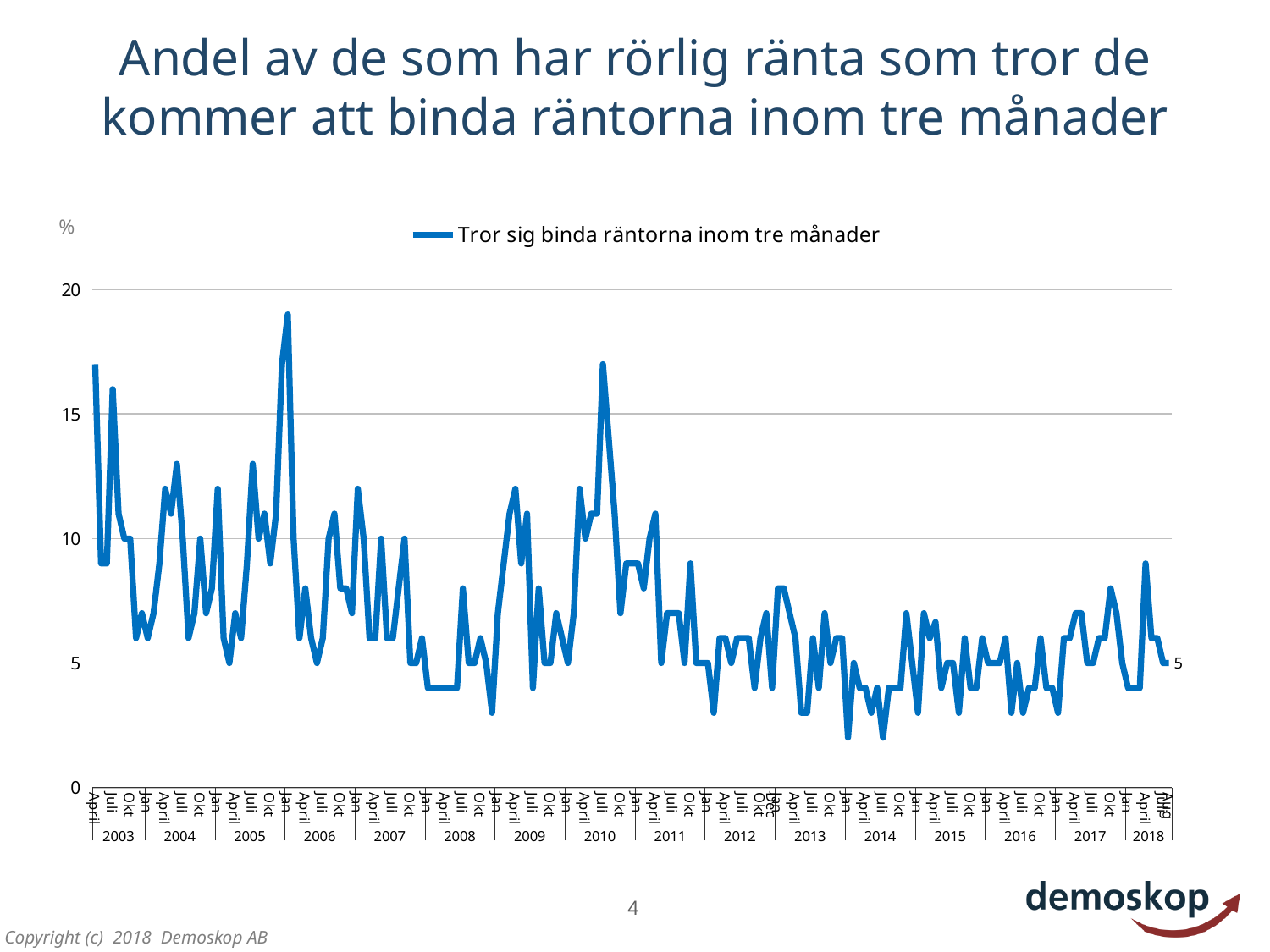
Overall, do the values rise or fall from 2003 to 2018? fall What is the name of the series shown in the legend? Tror sig binda räntorna inom tre månader How many years are labelled on the x axis? 16 What unit is shown on the y axis? % How many series does the legend list? 1 In which year does the line reach its highest point? 2006 What kind of chart is shown on the slide? line chart What is the value of the last data point (Aug 2018), as printed on the chart? 5 Is the value for Jan 2005 greater or less than 15? less Which is higher, the peak in Jan 2005 or the peak in July 2010? July 2010 Is the value for Aug 2018 greater or less than 10? less Is the value for April 2003 greater or less than 15? greater